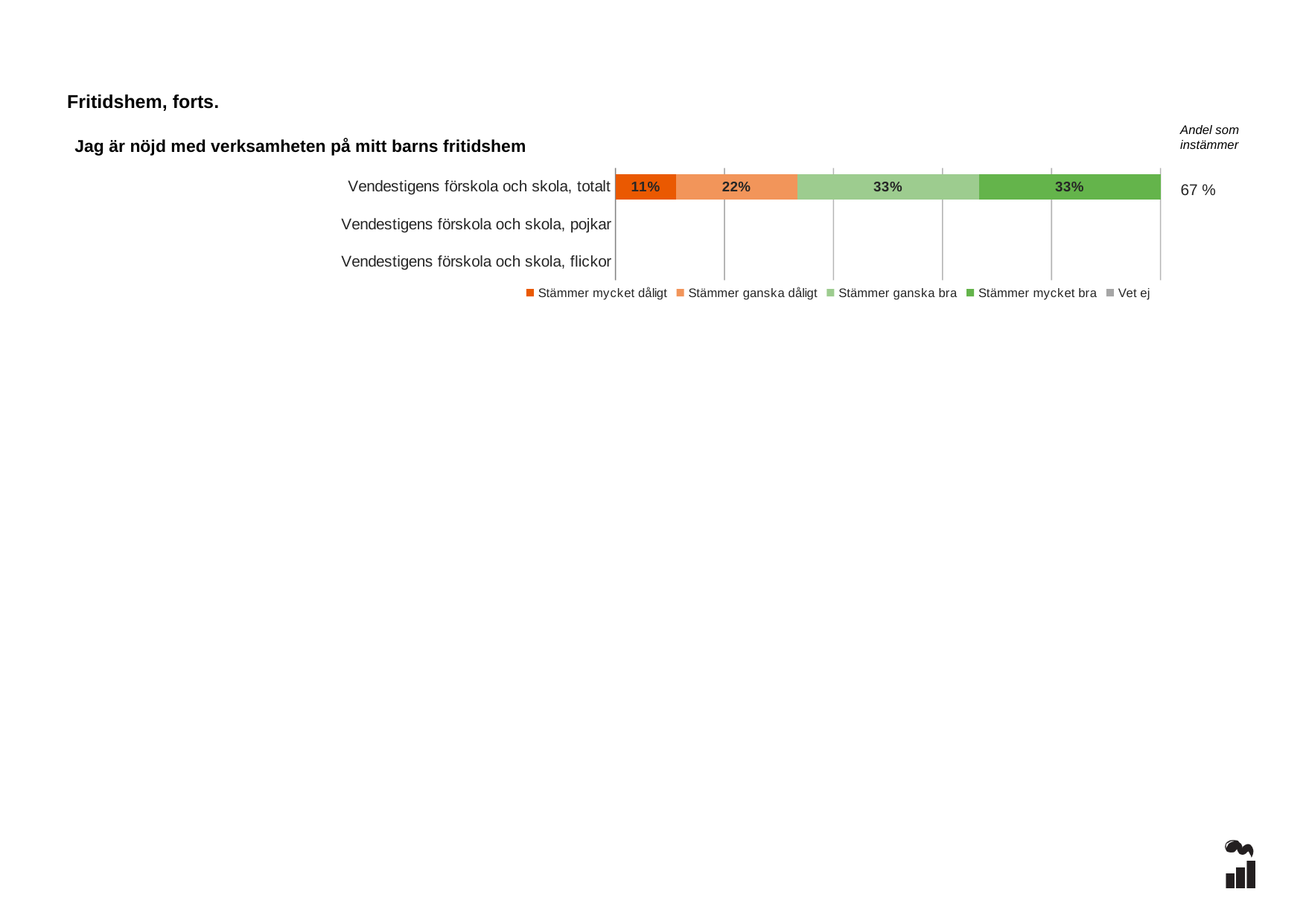
What kind of chart is shown on the slide? Stacked bar chart What percentage of respondents for "Vendestigens förskola och skola, totalt" answered "Stämmer mycket dåligt"? 11% What is the difference between the "Stämmer ganska dåligt" and "Stämmer mycket dåligt" shares for "Vendestigens förskola och skola, totalt"? 11% Which is larger for "Vendestigens förskola och skola, totalt": the "Stämmer ganska bra" share or the "Stämmer mycket dåligt" share? Stämmer ganska bra What is the title of the chart? Jag är nöjd med verksamheten på mitt barns fritidshem What is the combined share of "Stämmer mycket dåligt" and "Stämmer ganska dåligt" for "Vendestigens förskola och skola, totalt"? 33% What percentage of respondents for "Vendestigens förskola och skola, totalt" answered "Stämmer ganska dåligt"? 22% What percentage of respondents for "Vendestigens förskola och skola, totalt" answered "Stämmer ganska bra"? 33% What percentage of respondents for "Vendestigens förskola och skola, totalt" answered "Stämmer mycket bra"? 33% How many category rows are shown on the chart's vertical axis? 3 What is the "Andel som instämmer" value shown for "Vendestigens förskola och skola, totalt"? 67 % How many series does the legend list? 5